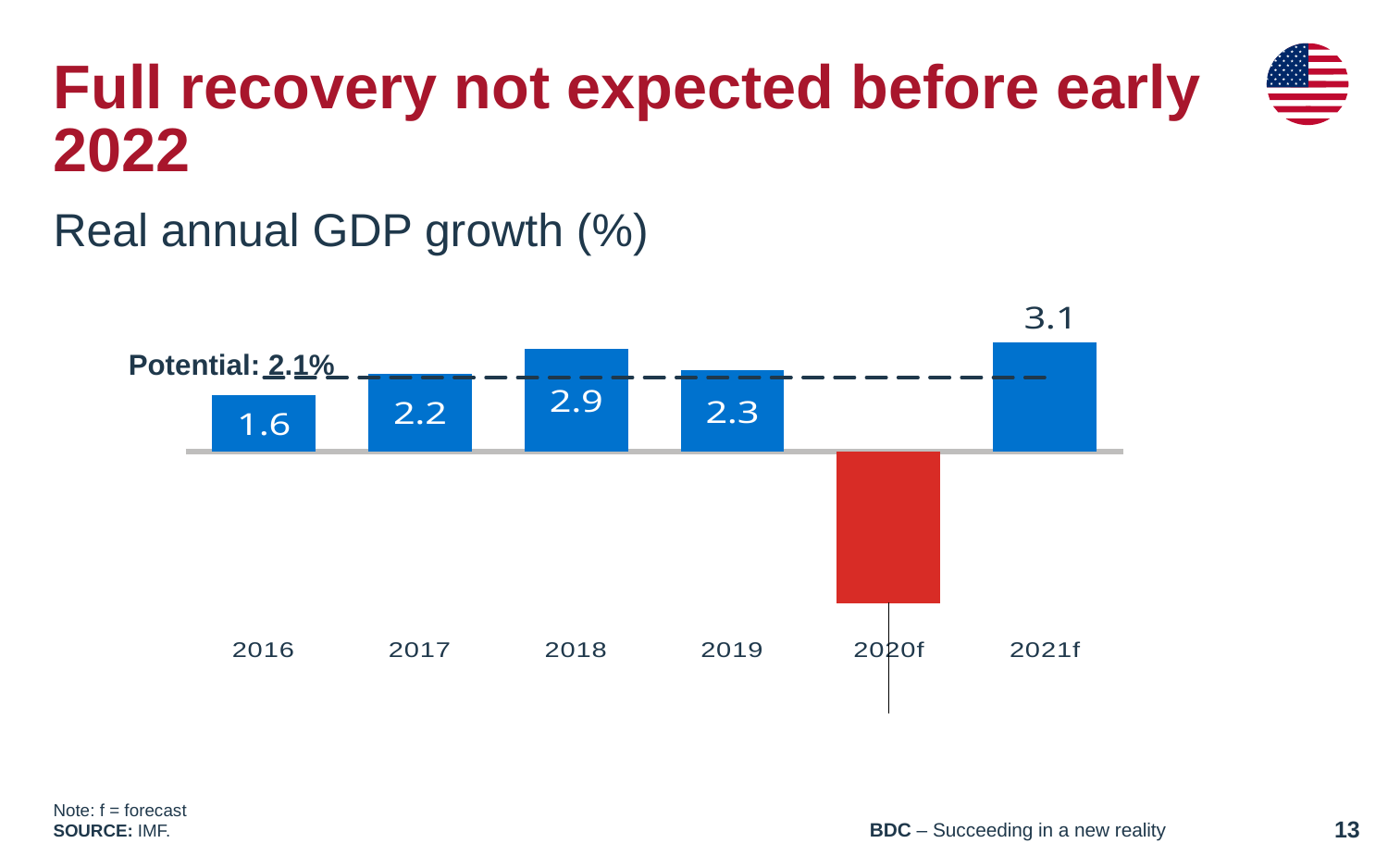
Which year has the lowest real annual GDP growth on the chart? 2020f How many years are shown on the chart? 6 Which year has the highest real annual GDP growth on the chart? 2021f What is the real annual GDP growth for 2018? 2.9 What is the difference between the GDP growth values for 2021f and 2019? 0.8 Is the value for 2020f greater or less than 0? less Which year has higher GDP growth, 2017 or 2019? 2019 What is the real annual GDP growth for 2016? 1.6 What kind of chart is shown on the slide? bar chart What potential growth rate is marked by the dashed line on the chart? 2.1% What is the forecast real annual GDP growth for 2021f? 3.1 What is the difference between the GDP growth values for 2018 and 2016? 1.3